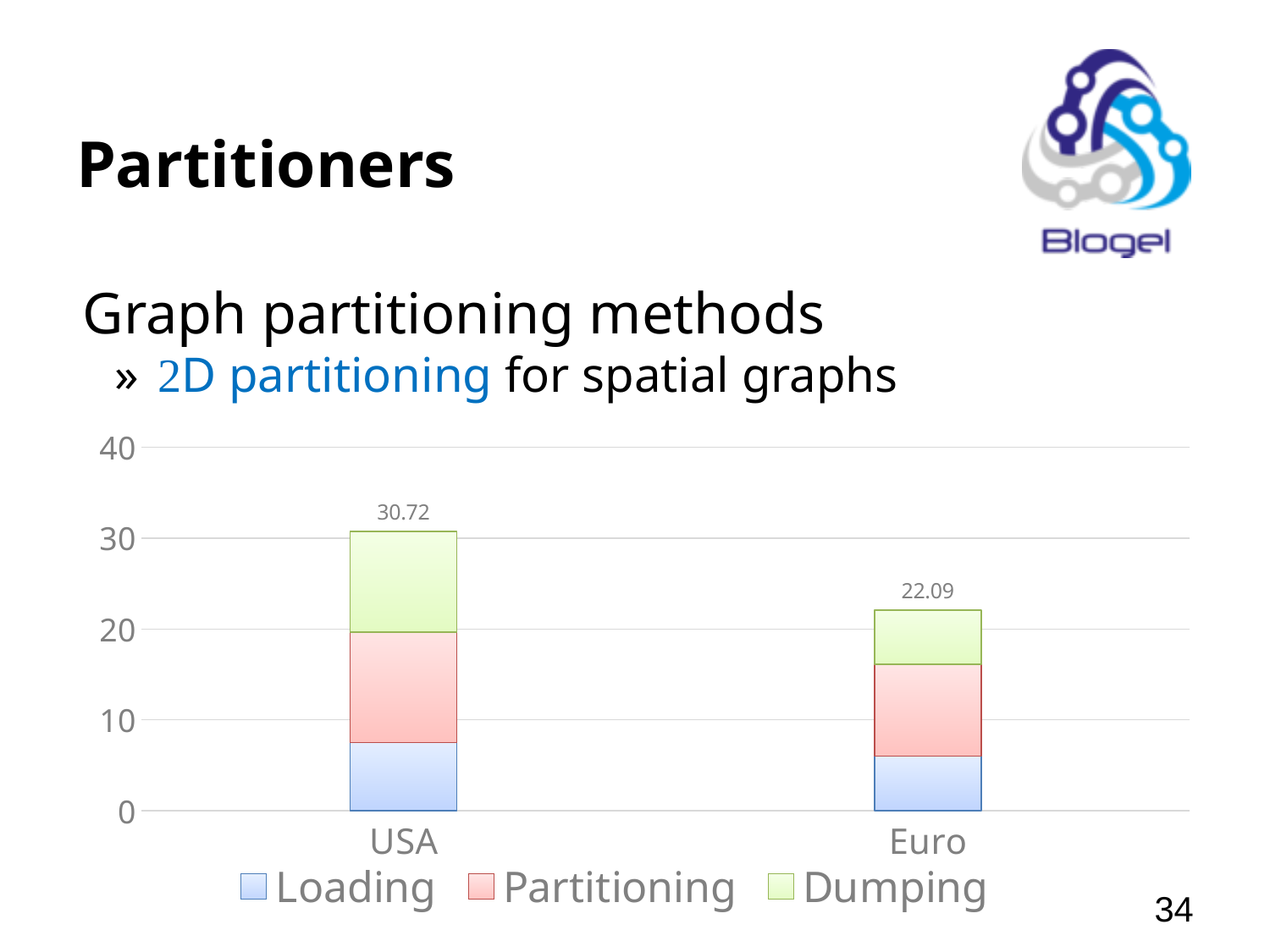
How many categories are shown on the x axis? 2 Is the Euro total greater or less than 30? less How many series does the legend list? 3 What is the difference between the USA total and the Euro total? 8.63 Which series appears at the bottom of each stacked bar? Loading Which category has the lowest total? Euro What kind of chart is shown on the slide? Stacked bar chart What is the total value shown for the USA bar? 30.72 What is the total value shown for the Euro bar? 22.09 Is the Loading value for Euro greater or less than 10? less Which category has the higher total, USA or Euro? USA Which series is shown in green in the legend? Dumping